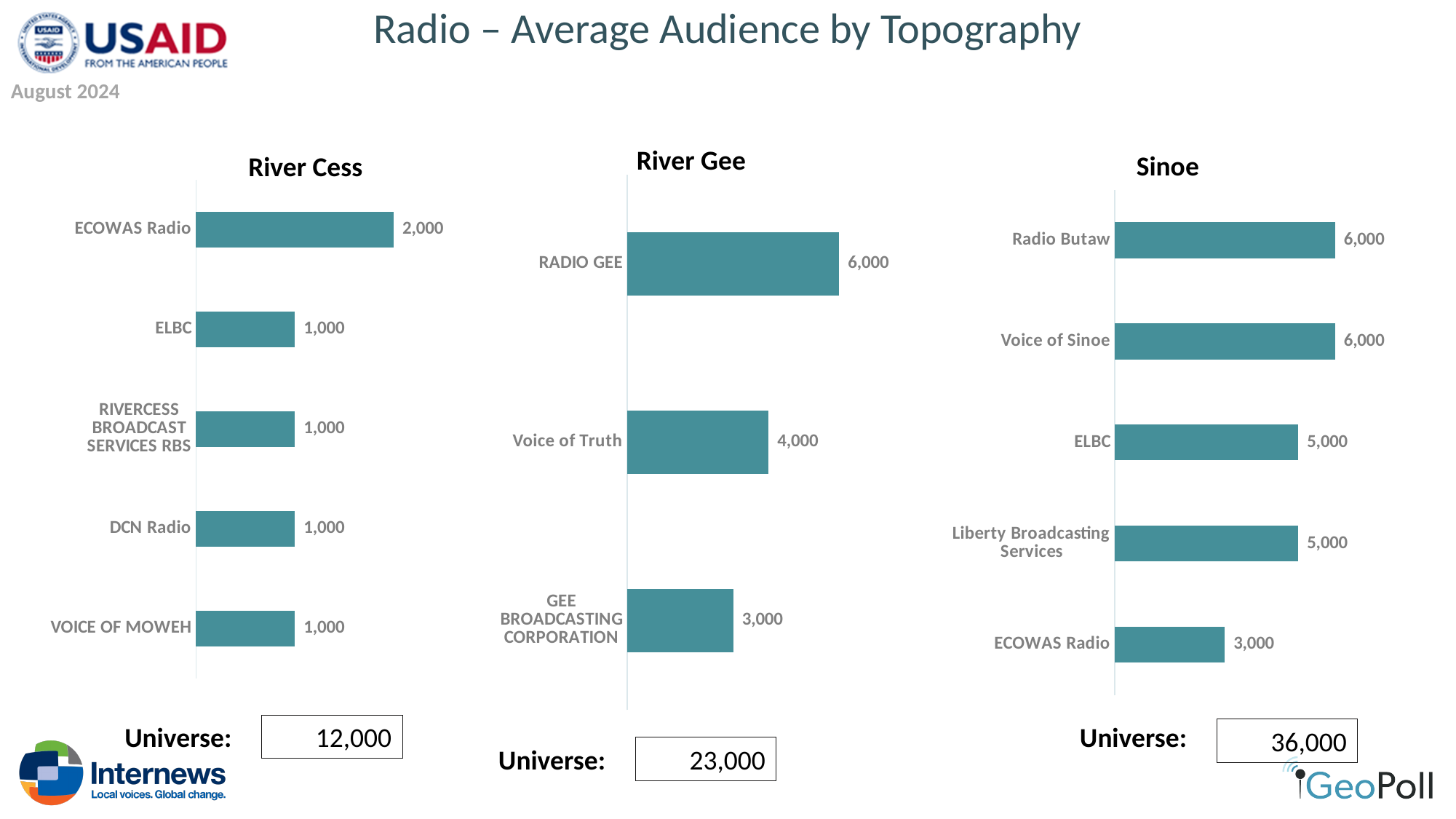
In the Sinoe chart, what is the difference between Radio Butaw and ELBC? 1,000 In the River Gee chart, what is the difference between RADIO GEE and GEE BROADCASTING CORPORATION? 3,000 How many stations are shown in the River Gee chart? 3 In the Sinoe chart, which station has the lowest average audience? ECOWAS Radio How many stations are shown in the Sinoe chart? 5 In the River Gee chart, what is the average audience for Voice of Truth? 4,000 In the River Cess chart, what is the average audience for ECOWAS Radio? 2,000 In the River Gee chart, which is larger: Voice of Truth or GEE BROADCASTING CORPORATION? Voice of Truth In the River Gee chart, which station has the highest average audience? RADIO GEE In the Sinoe chart, what is the average audience for ECOWAS Radio? 3,000 In the River Cess chart, which station has the highest average audience? ECOWAS Radio What type of chart is used for the River Cess data? Bar chart